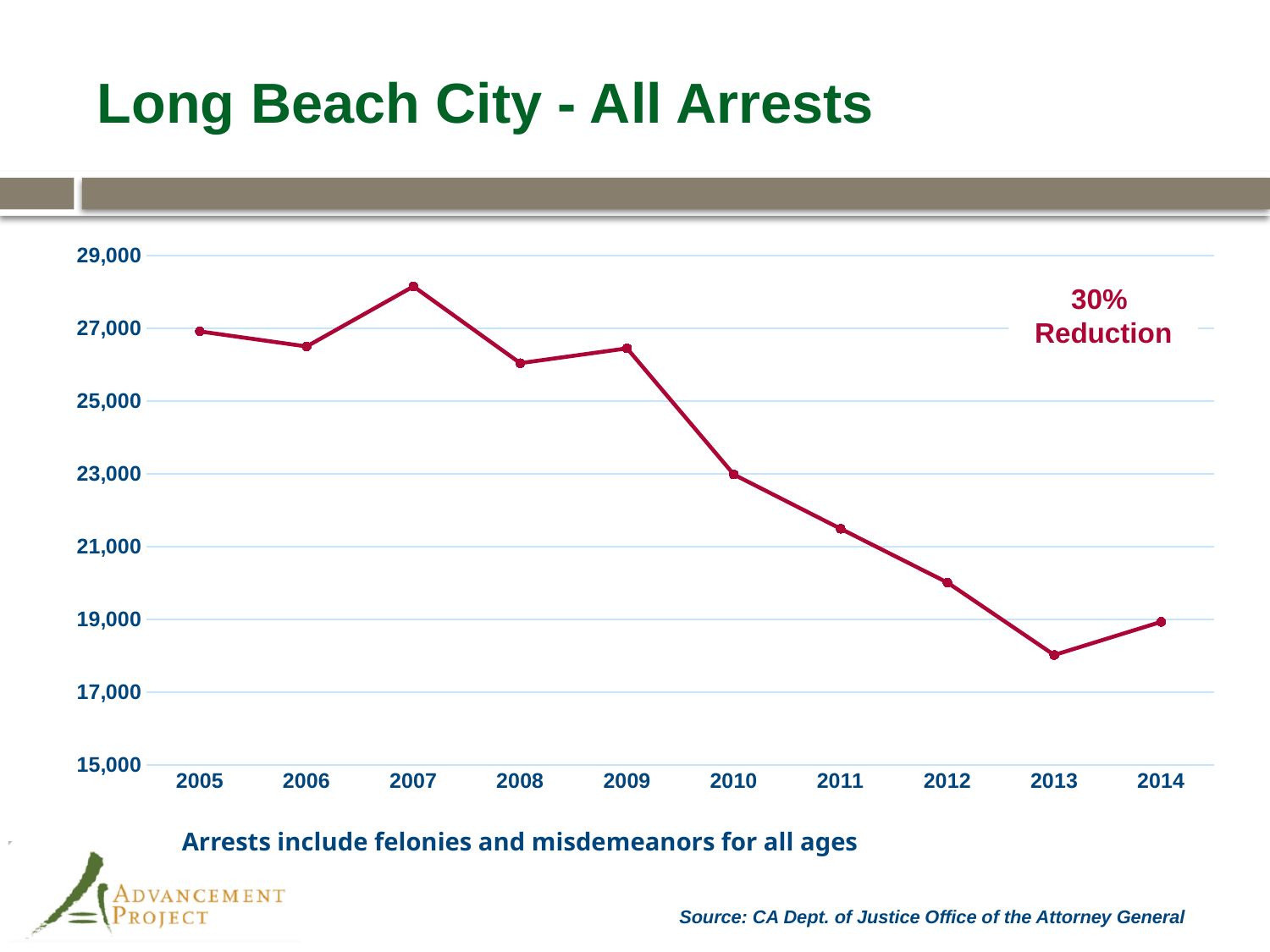
Is the value for 2007 greater or less than 27,000? greater What is the title of the chart? Long Beach City - All Arrests How many years are plotted on the x axis? 10 Which year has the lowest number of arrests? 2013 Is the value for 2013 greater or less than 19,000? less Which year has more arrests, 2009 or 2011? 2009 What kind of chart is shown on the slide? line chart Is the value for 2010 greater or less than 25,000? less Which year has the highest number of arrests? 2007 What percentage reduction is annotated on the chart? 30% Do arrests generally rise or fall from 2005 to 2014? fall